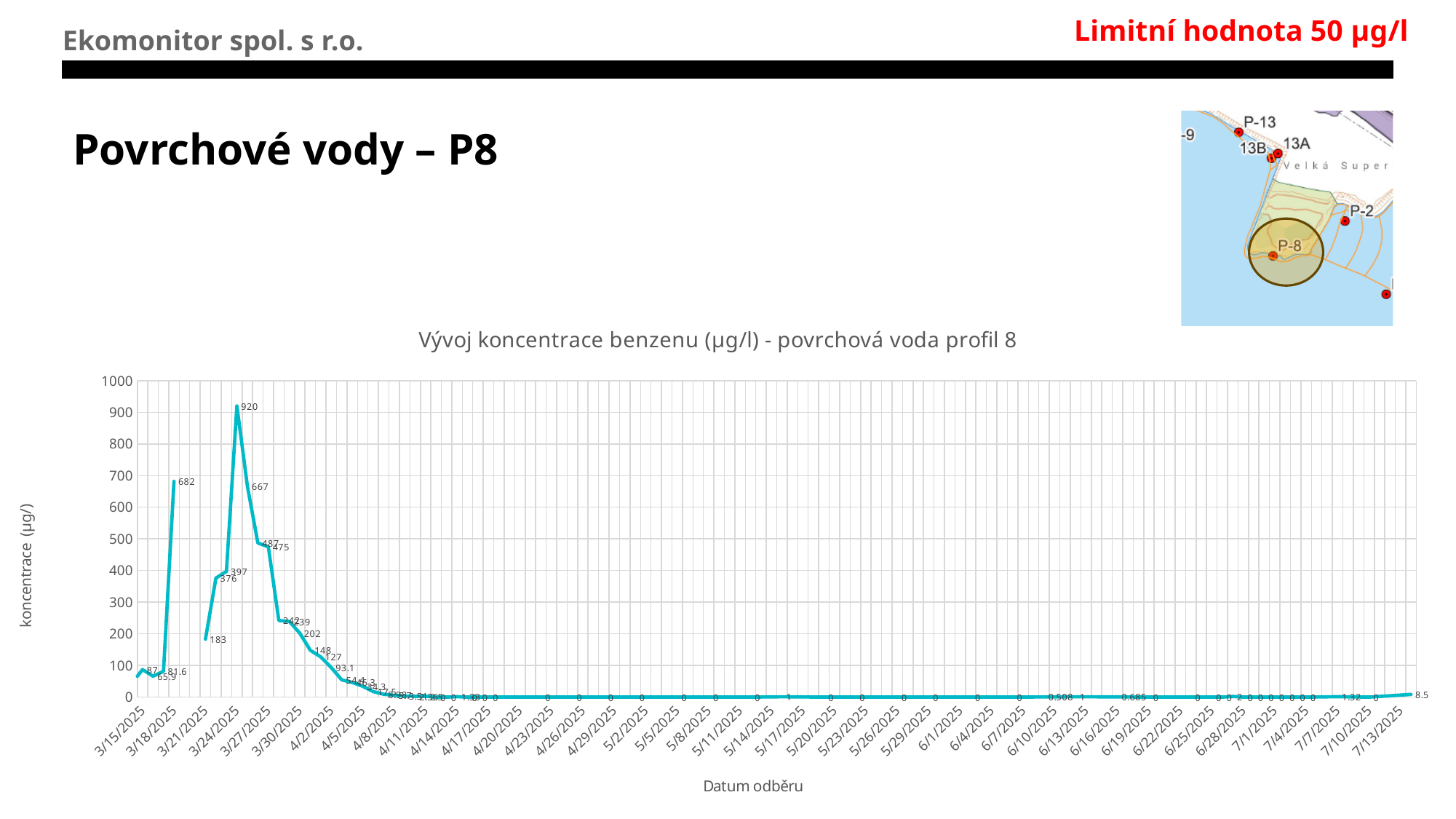
What is the highest benzene concentration value plotted on the chart? 920 What is the benzene concentration value plotted for 3/24/2025? 920 Is the value plotted for 3/18/2025 greater or less than 500? greater What is the difference between the peak value of 920 and the earlier peak of 682? 238 What is the difference between the values labelled 487 and 475? 12 What is the label of the vertical axis of the chart? koncentrace (µg/l) After the peak in late March 2025, do the plotted values rise or fall over the following dates? fall What is the benzene concentration value plotted for the last date, 7/13/2025? 8.5 Which is larger, the value labelled 667 or the value labelled 487? 667 What kind of chart is shown on the slide? line chart What is the title of the chart? Vývoj koncentrace benzenu (µg/l) - povrchová voda profil 8 Is the value plotted for 5/14/2025 greater or less than 100? less